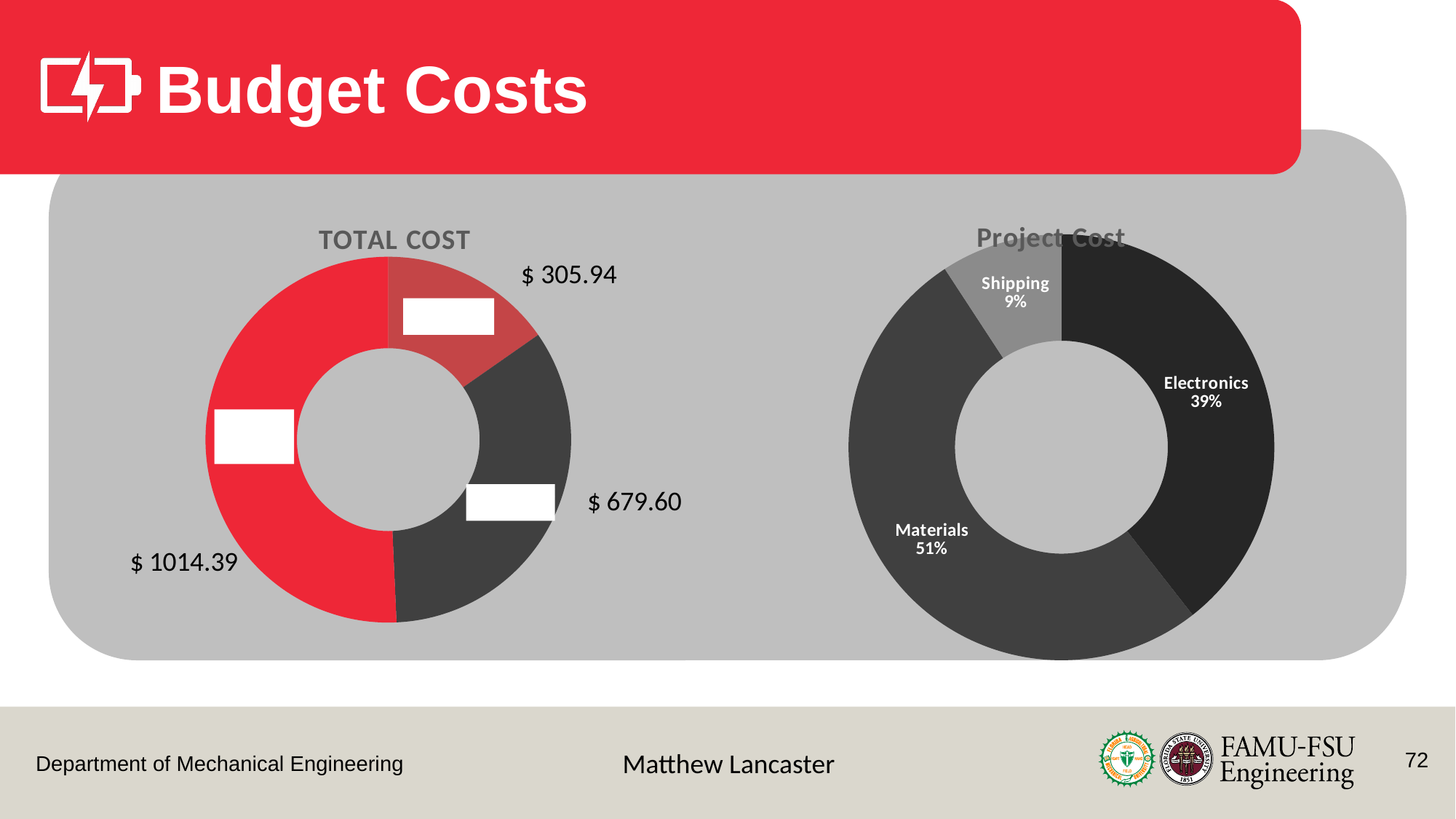
In the "TOTAL COST" chart, what value is labelled on the red slice? $ 1014.39 In the "Project Cost" chart, how much larger is the Materials share than the Electronics share? 12% In the "Project Cost" chart, which category has the smallest share? Shipping In the "Project Cost" chart, what share does Materials have? 51% In the "Project Cost" chart, what share does Shipping have? 9% In the "TOTAL COST" chart, what is the smallest value shown? $ 305.94 How many slices does the "TOTAL COST" chart have? 3 In the "Project Cost" chart, which category has the largest share? Materials In the "TOTAL COST" chart, what is the largest value shown? $ 1014.39 In the "TOTAL COST" chart, what is the sum of the three values shown? $ 1999.93 In the "TOTAL COST" chart, what is the difference between the largest and smallest values? $ 708.45 What kind of chart is the "TOTAL COST" chart on the left? Donut (pie) chart